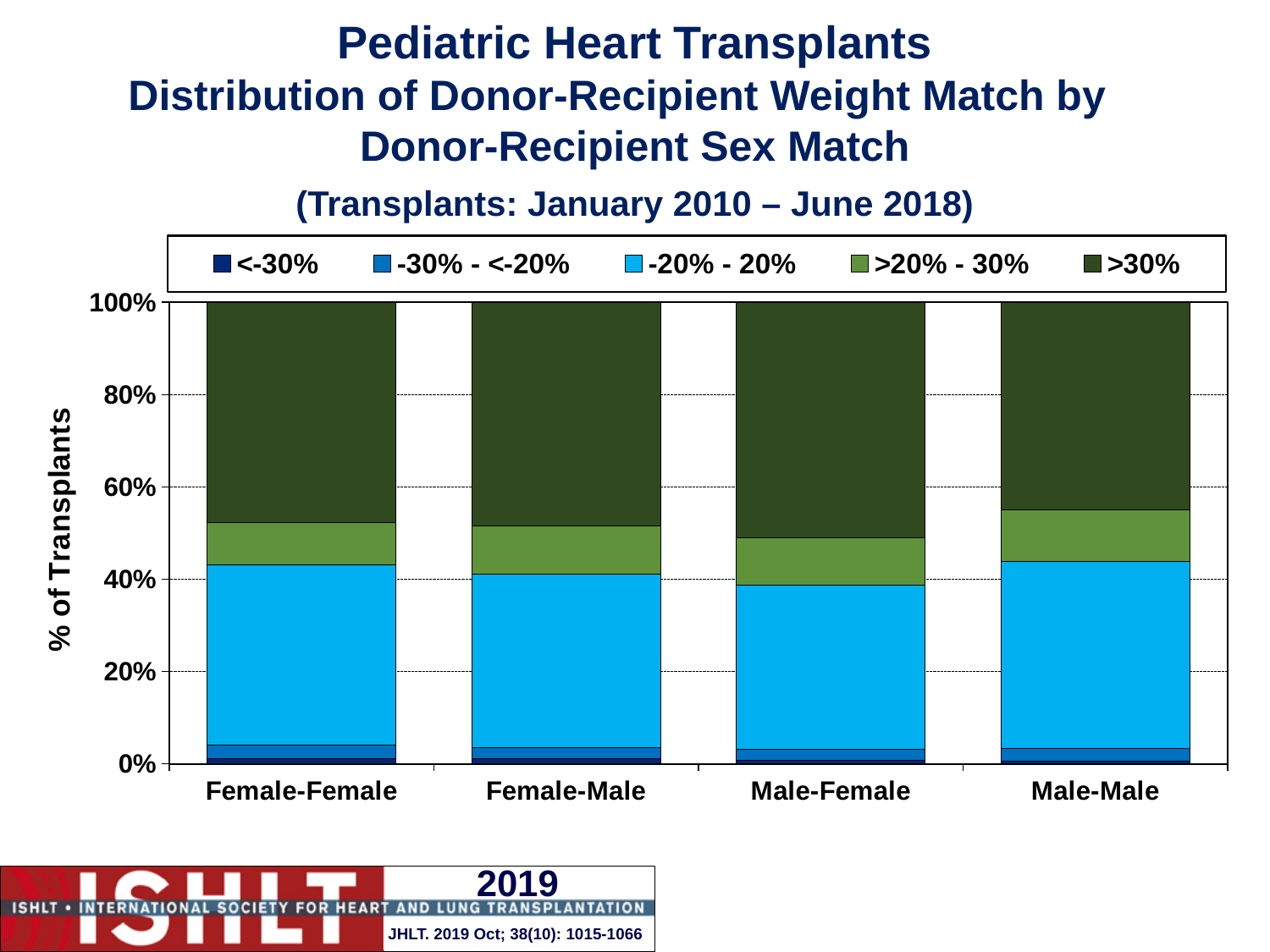
What is the label of the y axis? % of Transplants How many series does the legend list? 5 What kind of chart is shown on the slide? Stacked bar chart What transplant date range is given in the chart subtitle? January 2010 – June 2018 What is the total height of the Male-Male stacked bar? 100% Is the cumulative share of the Male-Female bar up to the top of the >20% - 30% segment greater or less than 60%? less Which category has the largest >30% segment? Male-Female Which category has the smallest >30% segment? Male-Male Is the cumulative share of the Female-Female bar up to the top of the >20% - 30% segment greater or less than 60%? less Is the >30% segment larger for Male-Female or for Male-Male? Male-Female How many donor-recipient sex match categories are shown on the x axis? 4 Is the cumulative share of the Male-Male bar up to the top of the -20% - 20% segment greater or less than 40%? greater